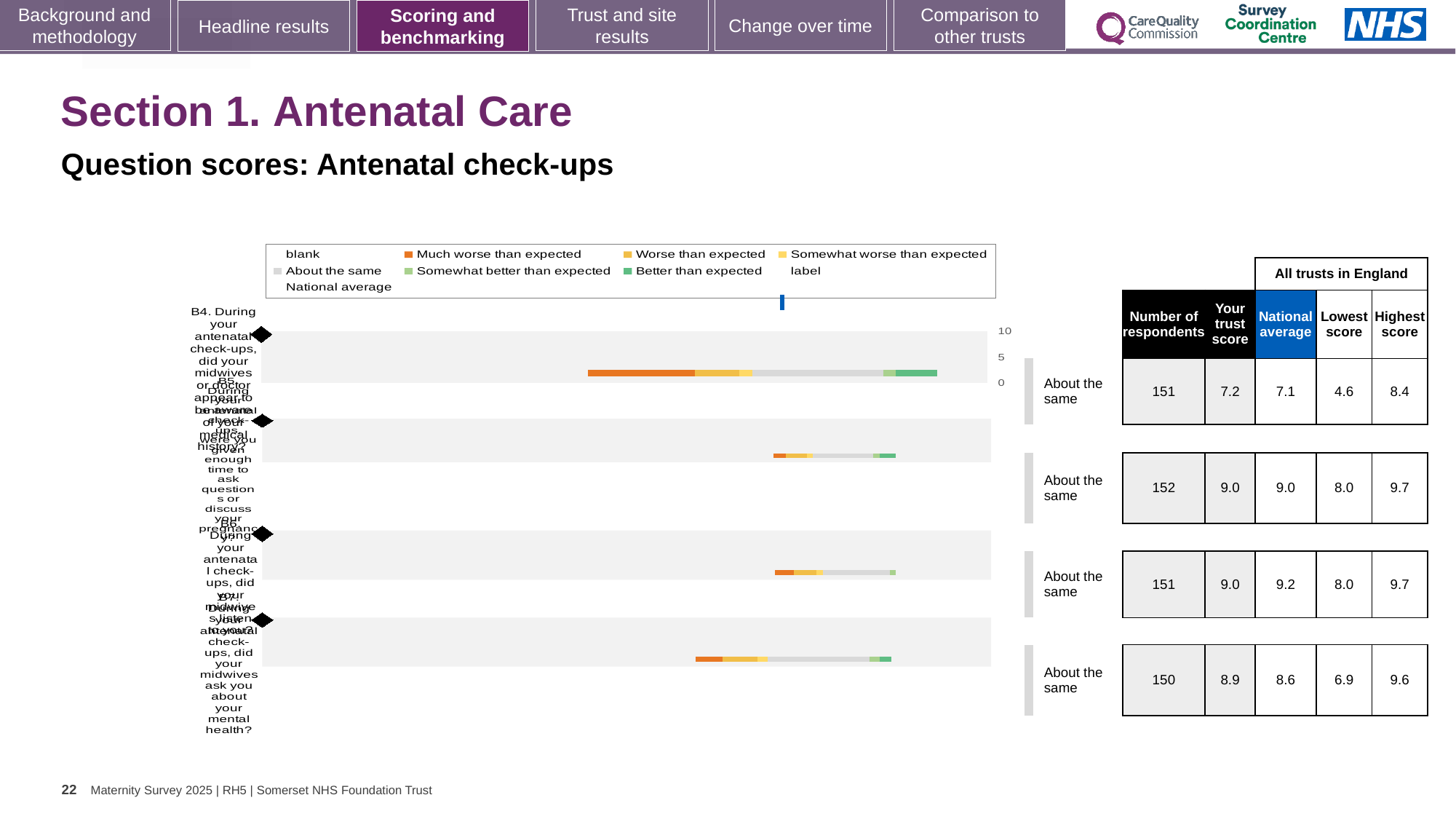
What is the difference between the highest score and the lowest score for question B4? 3.8 Which question has the lowest 'Lowest score' value in the table beside the chart? B4 What is the national average for question B6 in the table beside the chart? 9.2 What benchmark category is shown for question B5 next to the chart? About the same In the chart legend, what colour represents 'Much worse than expected'? orange How many respondents answered question B7 according to the table beside the chart? 150 What kind of chart is shown on the slide? bar chart In the chart legend, what colour represents 'Better than expected'? green Which question has the lowest 'Your trust score' in the table beside the chart? B4 What is the 'Your trust score' for question B4 in the table beside the chart? 7.2 How many survey questions (bars) are plotted in the chart? 4 For question B7, is the trust score or the national average larger? trust score